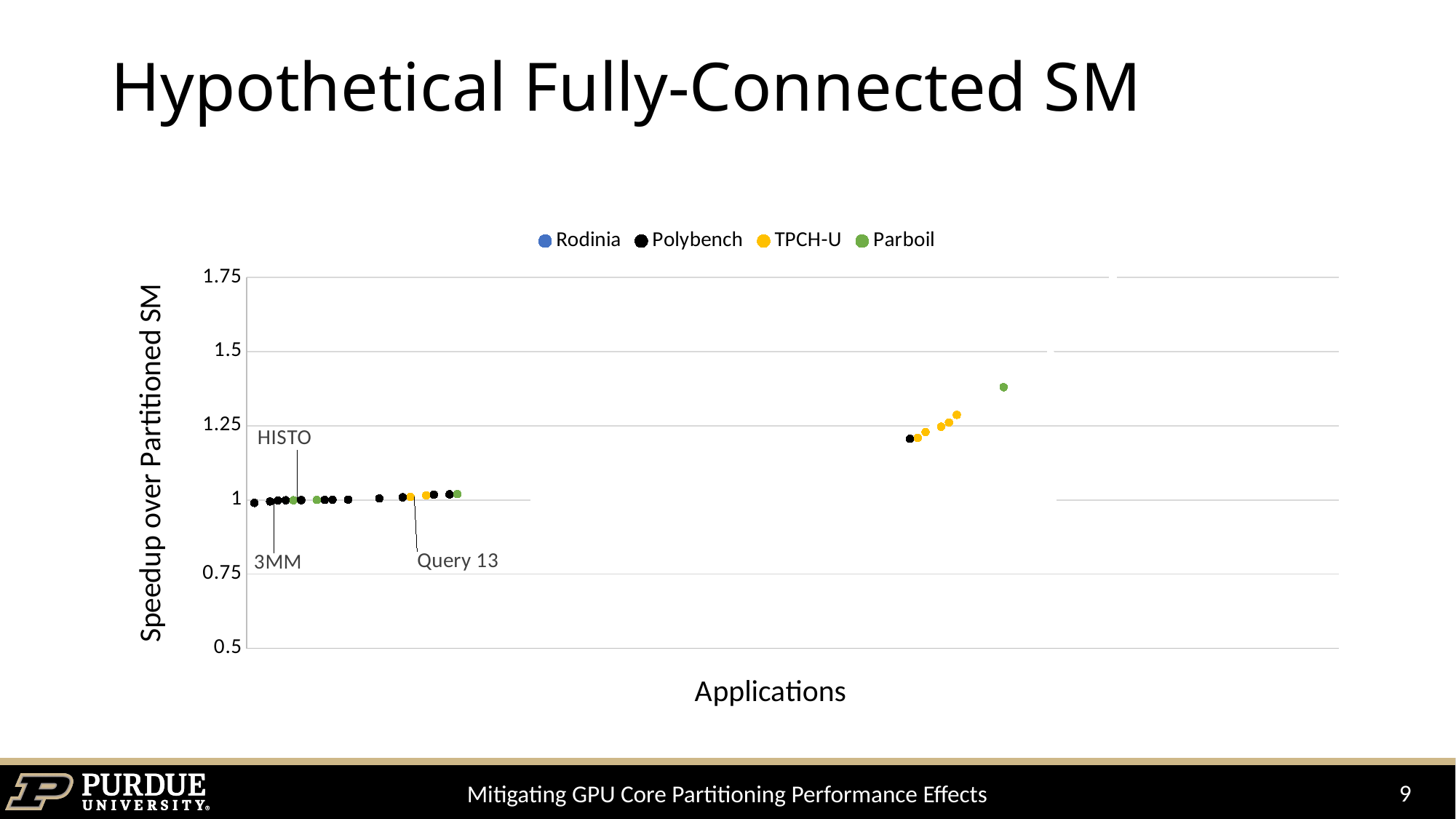
Is the value for HISTO greater or less than 1.25? less Is the value for 3MM greater or less than 1.25? less Is the highest plotted point greater or less than 1.25? greater Do the plotted values rise or fall from left to right along the x axis? rise What kind of chart is shown on the slide? scatter chart How many series does the legend list? 4 What is the title of the vertical axis? Speedup over Partitioned SM Which series does the highest plotted point belong to? Parboil What is the title of the horizontal axis? Applications How many individual applications are labelled with annotations on the chart? 3